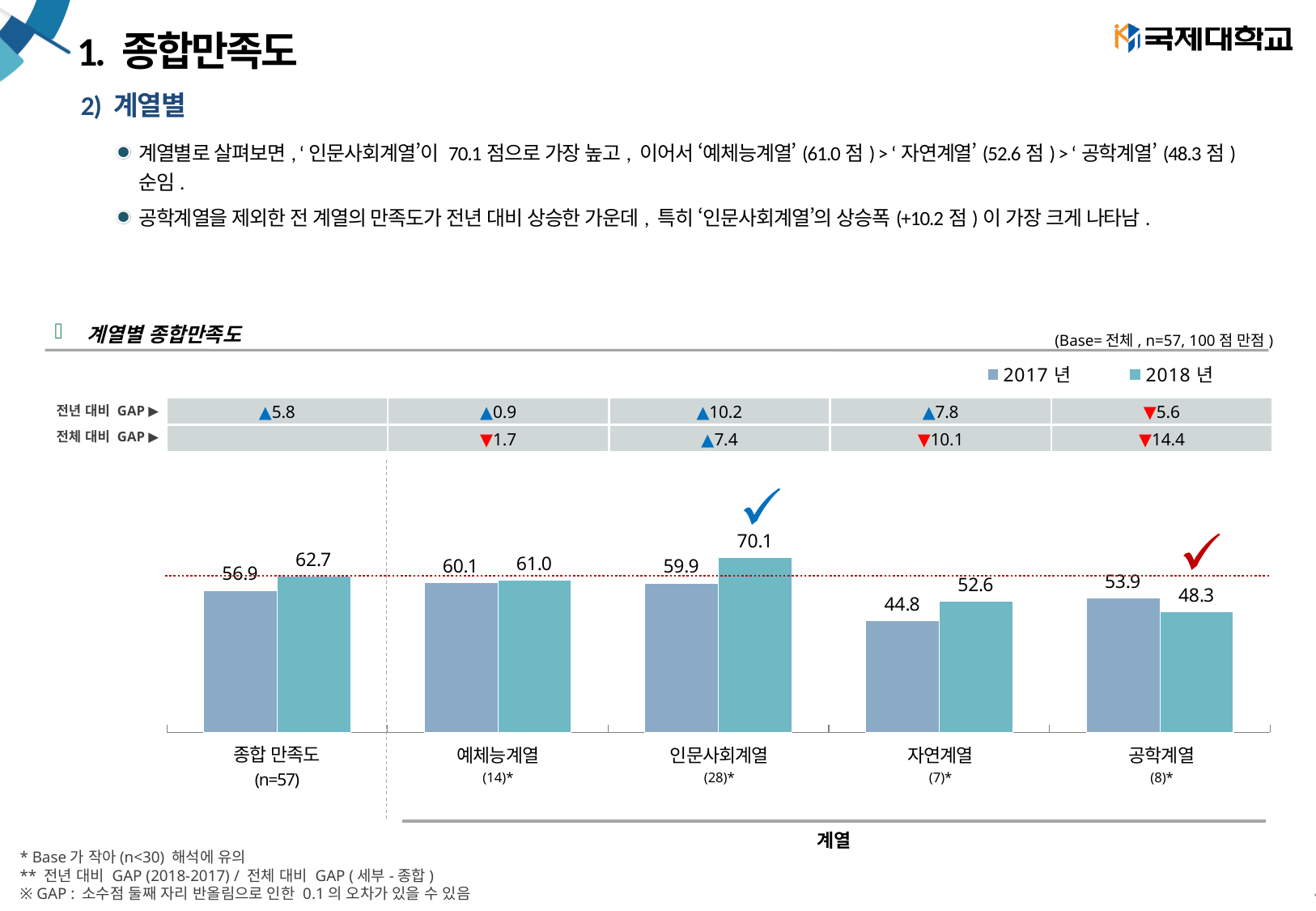
What is the 2018년 value for 인문사회계열? 70.1 What type of chart is shown on the slide? bar chart Which category has the highest 2018년 value? 인문사회계열 What is the difference between the 2018년 values for 예체능계열 and 자연계열? 8.4 What is the 2017년 value for 자연계열? 44.8 Which series is shown in the darker blue-grey colour in the legend? 2017년 How many series does the chart legend list? 2 How many categories are shown along the x axis of the chart? 5 Which category has the lowest 2017년 value? 자연계열 What is the difference between the 2018년 and 2017년 values for 인문사회계열? 10.2 What is the 2018년 value for 종합 만족도? 62.7 Which is larger for 공학계열, the 2017년 value or the 2018년 value? 2017년